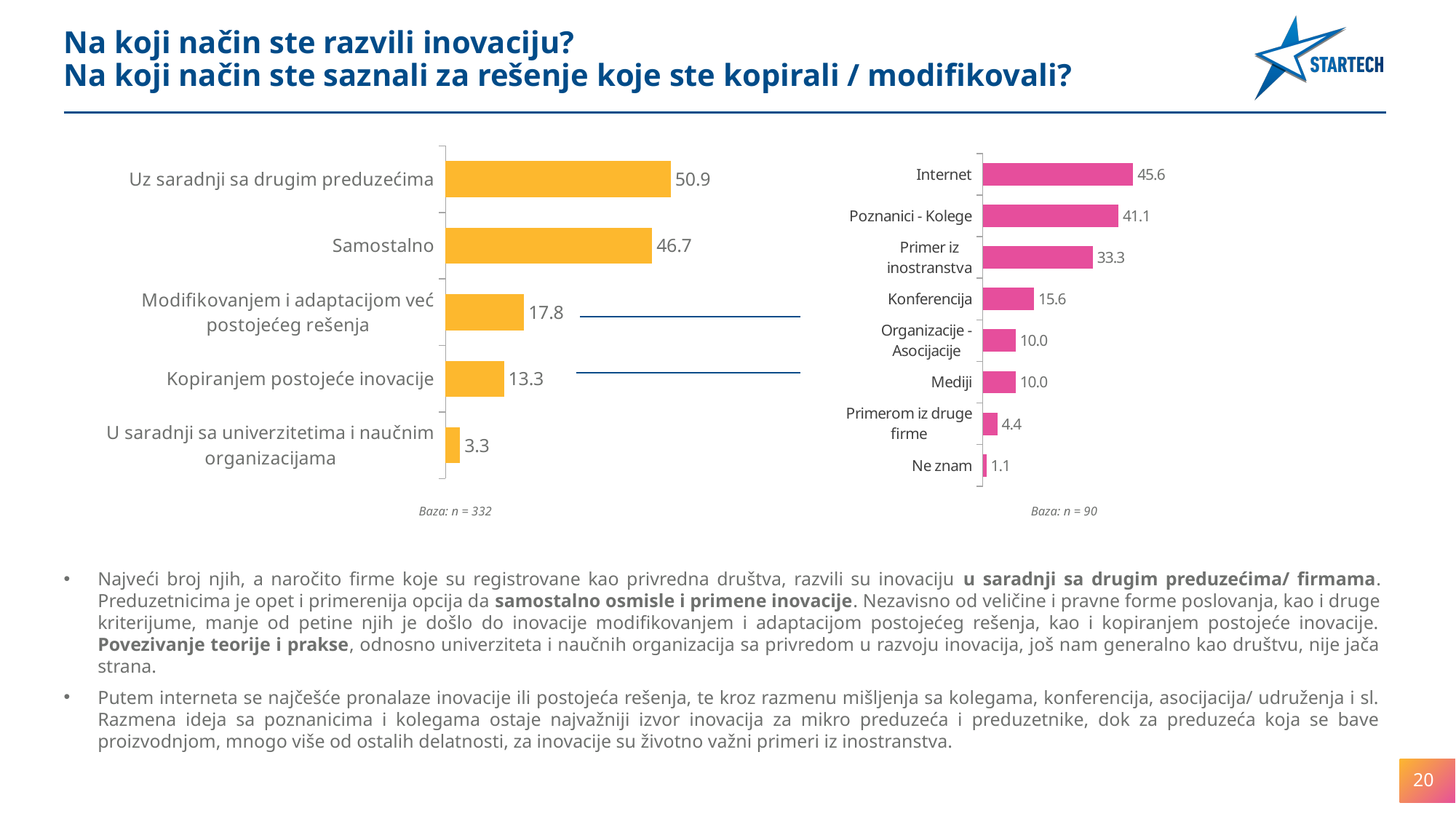
On the left chart, which category has the lowest value? U saradnji sa univerzitetima i naučnim organizacijama On the right chart, how many categories are shown? 8 On the right chart, what is the difference between 'Internet' and 'Poznanici - Kolege'? 4.5 On the right chart, which is larger: 'Poznanici - Kolege' or 'Primer iz inostranstva'? Poznanici - Kolege On the right chart, which category has the lowest value? Ne znam On the right chart, what is the value for 'Konferencija'? 15.6 On the left chart, what is the value for 'Samostalno'? 46.7 What type of chart is the left chart? Bar chart On the left chart, how many categories are shown? 5 On the left chart, which category has the highest value? Uz saradnji sa drugim preduzećima On the right chart, which category has the highest value? Internet On the left chart, what is the difference between 'Modifikovanjem i adaptacijom već postojećeg rešenja' and 'Kopiranjem postojeće inovacije'? 4.5